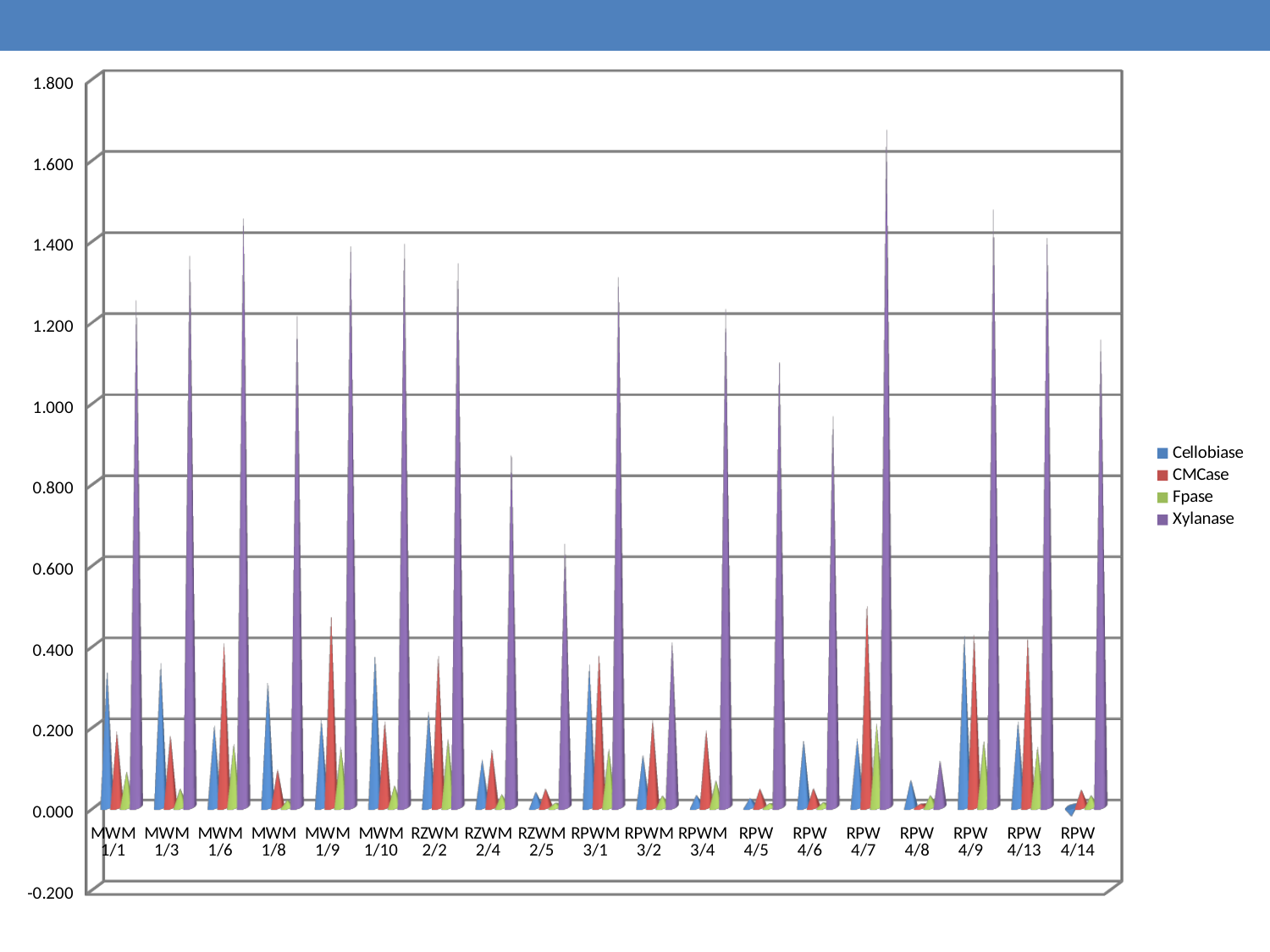
Which category has the lowest Xylanase value? RPW 4/8 Is the CMCase value for RPW 4/7 greater or less than 0.200? greater Which category has the highest Xylanase value? RPW 4/7 Which series is shown in purple in the legend? Xylanase Is the Xylanase value for RPW 4/7 greater or less than 1.400? greater Is the Cellobiase value for RPW 4/9 greater or less than 0.200? greater How many series does the legend list? 4 What kind of chart is shown on the slide? bar chart Which series is listed first in the legend? Cellobiase How many categories are shown along the x axis? 19 For MWM 1/1, which is larger: the Xylanase value or the Cellobiase value? Xylanase